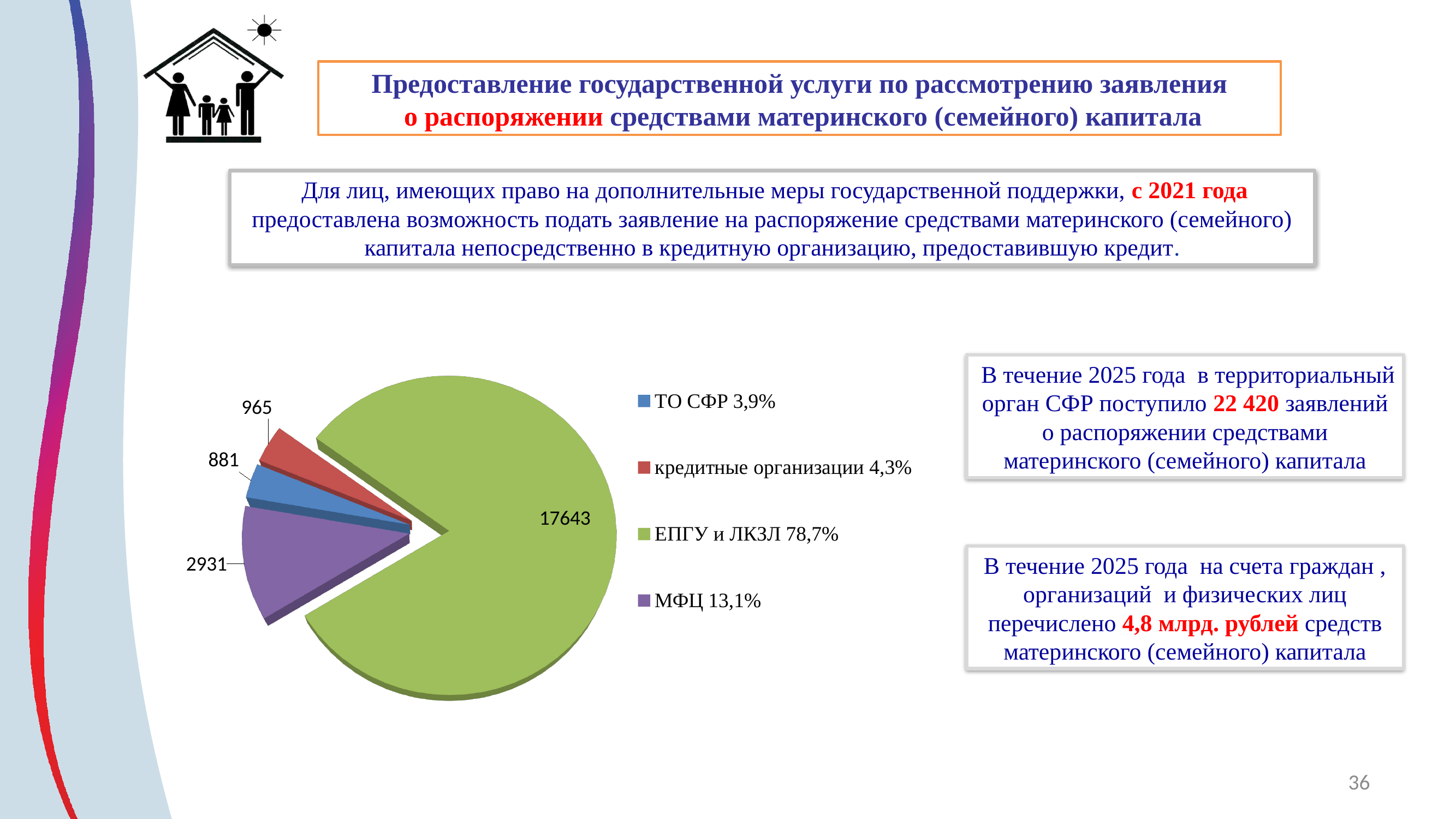
What type of chart is shown on the slide? pie chart What value is shown for the кредитные организации slice of the pie chart? 965 Which category has the smallest slice in the pie chart? ТО СФР What value is shown for the ТО СФР slice of the pie chart? 881 What value is shown for the МФЦ slice of the pie chart? 2931 What is the difference between the values for МФЦ and кредитные организации in the pie chart? 1966 What share of the pie does ЕПГУ и ЛКЗЛ represent, according to the legend? 78,7% What colour is the ЕПГУ и ЛКЗЛ slice in the pie chart? green Which category has the largest slice in the pie chart? ЕПГУ и ЛКЗЛ What value is shown for the ЕПГУ и ЛКЗЛ slice of the pie chart? 17643 How many slices does the pie chart have? 4 What share of the pie does МФЦ represent, according to the legend? 13,1%